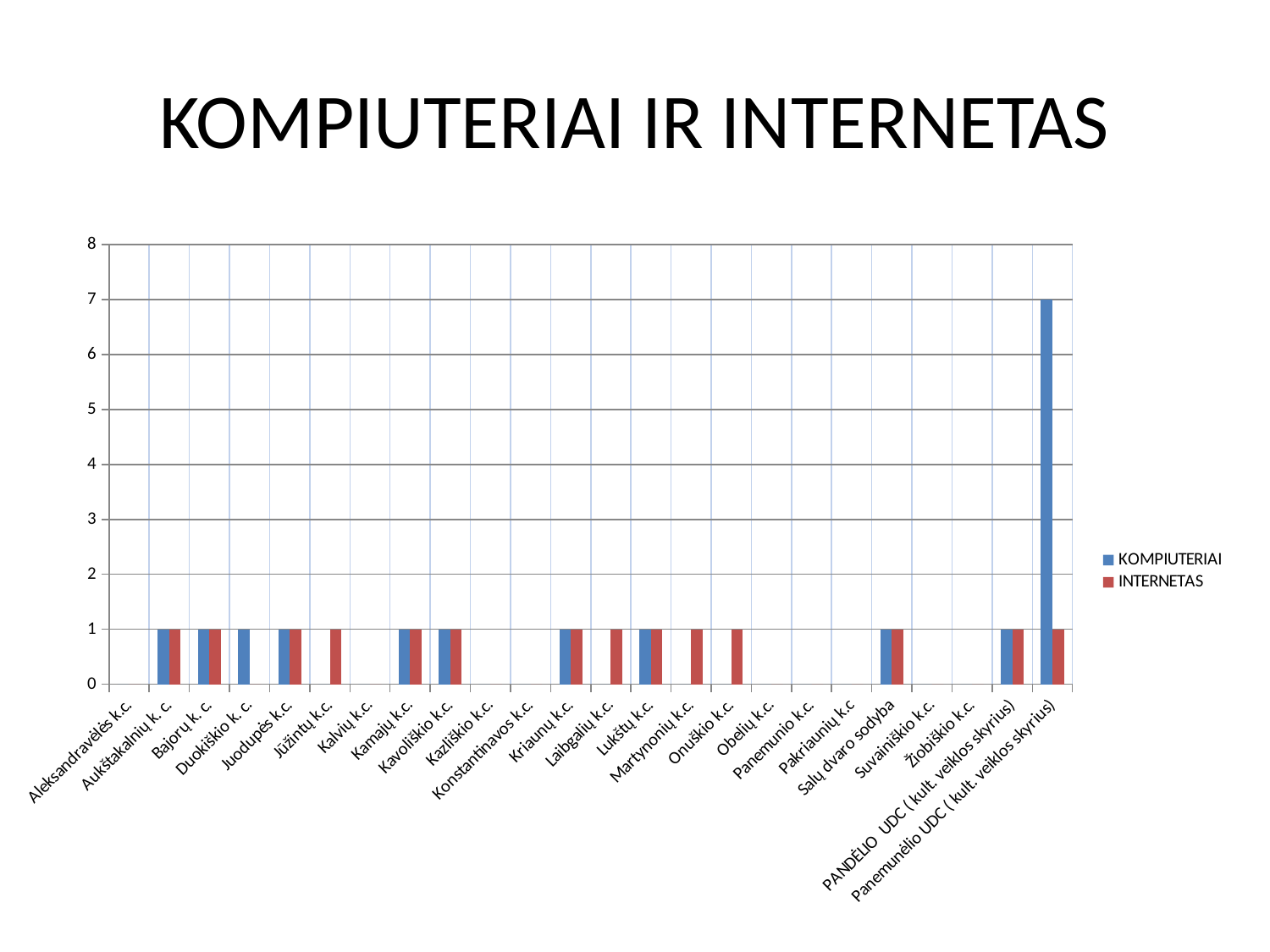
What is the INTERNETAS value for Panemunėlio UDC ( kult. veiklos skyrius)? 1 What is the difference between the KOMPIUTERIAI and INTERNETAS values for Panemunėlio UDC ( kult. veiklos skyrius)? 6 How many categories are shown on the x axis? 24 What is the title of the chart? KOMPIUTERIAI IR INTERNETAS What is the KOMPIUTERIAI value for Panemunėlio UDC ( kult. veiklos skyrius)? 7 Which is larger for Jūžintų k.c., the KOMPIUTERIAI value or the INTERNETAS value? INTERNETAS How many series does the legend list? 2 What kind of chart is shown on the slide? bar chart What are the two series named in the legend? KOMPIUTERIAI and INTERNETAS Is the KOMPIUTERIAI value for Panemunėlio UDC ( kult. veiklos skyrius) greater or less than 5? greater What is the KOMPIUTERIAI value for Duokiškio k. c.? 1 Which category has the highest KOMPIUTERIAI value? Panemunėlio UDC ( kult. veiklos skyrius)